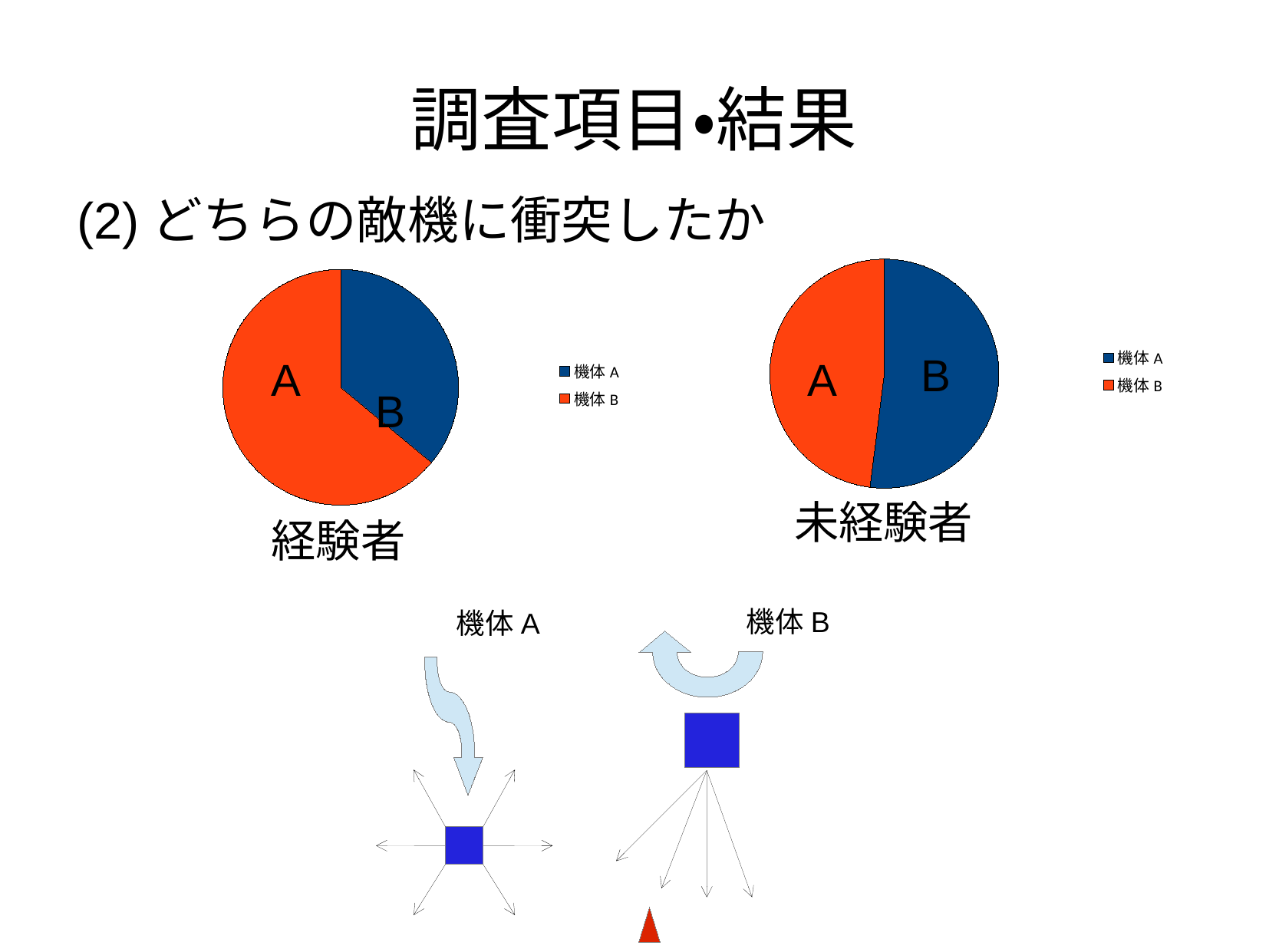
In the 経験者 pie chart, which labelled slice is the smallest? B What are the labels under the left and right pie charts? 経験者 (left), 未経験者 (right) How many entries does the legend of the 経験者 pie chart list? 2 How many entries does the legend of the 未経験者 pie chart list? 2 What kind of chart is the 経験者 chart on the left? Pie chart In the 経験者 pie chart, which labelled slice is the largest? A What kind of chart is the 未経験者 chart on the right? Pie chart What are the two entries listed in the legend of the 未経験者 pie chart? 機体 A, 機体 B How many slices does the 未経験者 pie chart have? 2 How many slices does the 経験者 pie chart have? 2 In the 経験者 pie chart, which slice is larger, the one labelled A or the one labelled B? A